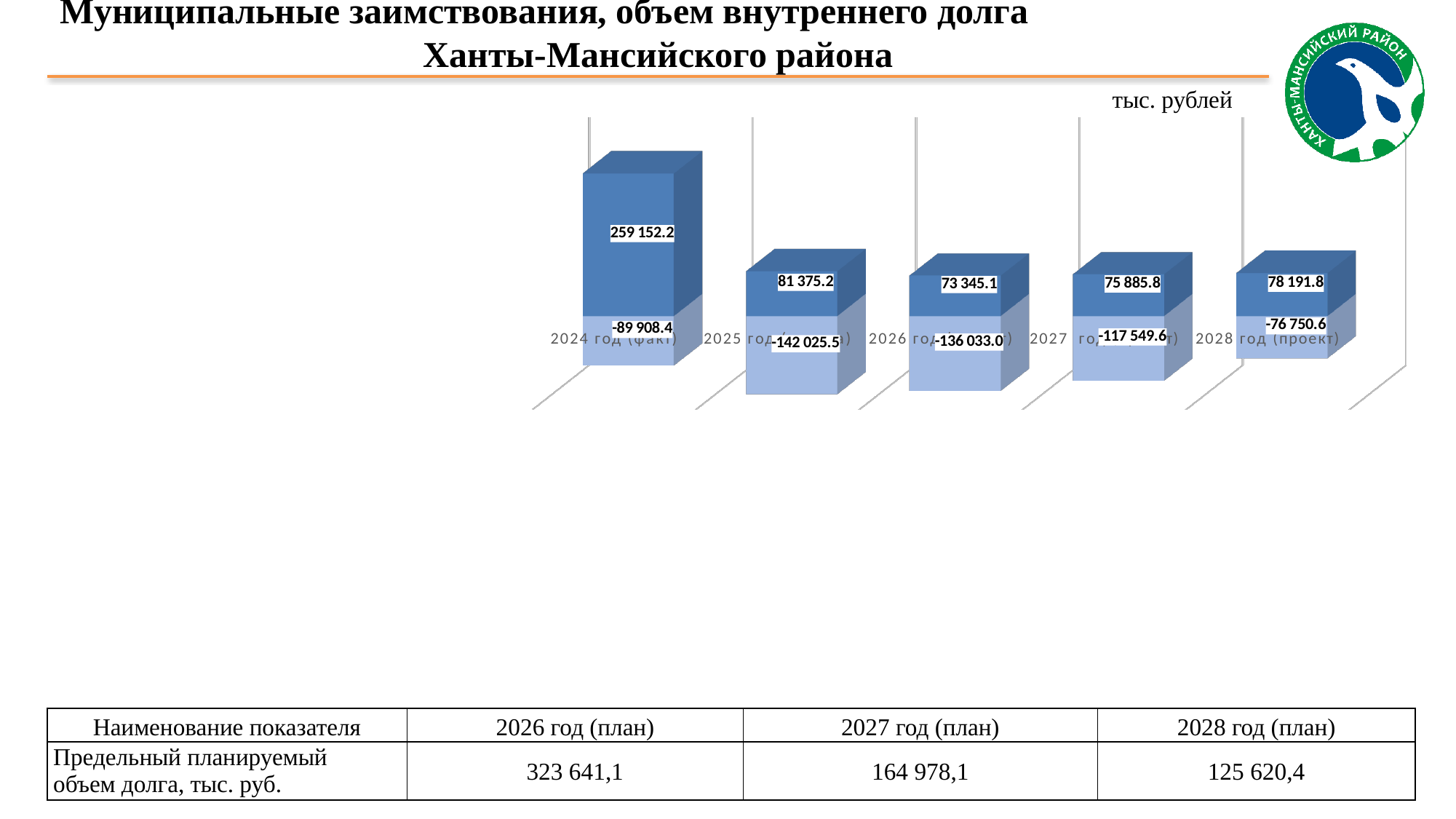
Which year has the lowest positive (upper) value? 2026 год What type of chart is shown on the slide? Bar chart Which is larger in absolute terms: the negative value for 2025 год or for 2028 год (проект)? 2025 год What is the negative (lower) value shown for 2025 год? -142 025.5 How many years (categories) are shown on the chart? 5 What unit of measurement is indicated above the chart? тыс. рублей Which year has the highest positive (upper) value? 2024 год (факт) What is the positive (upper) value shown for 2028 год (проект)? 78 191.8 What is the difference between the positive values for 2024 год (факт) and 2025 год? 177 777.0 What is the negative (lower) value shown for 2024 год (факт)? -89 908.4 What is the positive (upper) value shown for 2026 год? 73 345.1 What is the positive (upper) value shown for 2024 год (факт)? 259 152.2